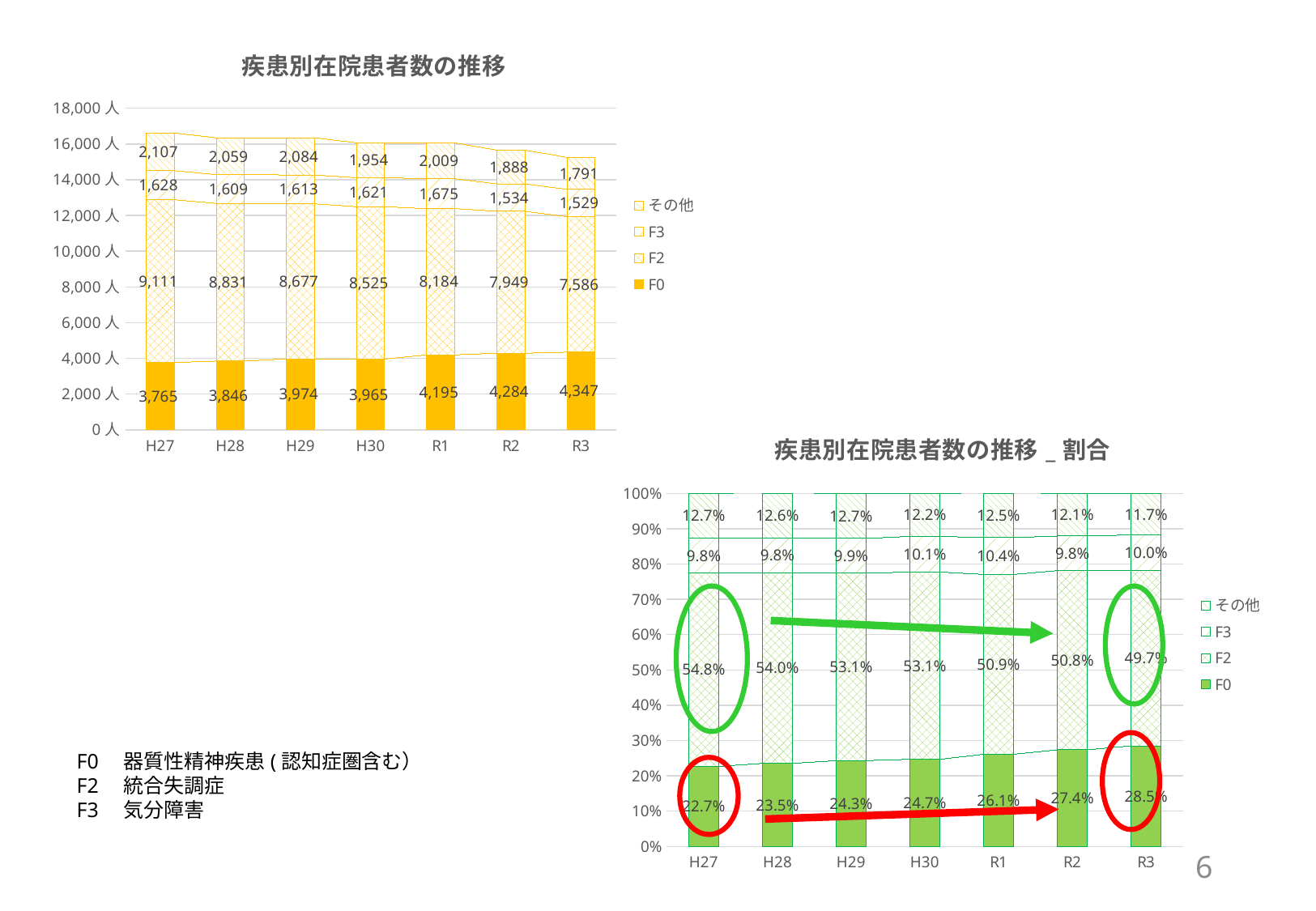
In the chart titled 疾患別在院患者数の推移＿割合, what is the value for F2 in H27? 54.8% What kind of chart is the chart titled 疾患別在院患者数の推移＿割合? stacked bar chart In the chart titled 疾患別在院患者数の推移, does the F2 value rise or fall from H27 to R3? fall In the chart titled 疾患別在院患者数の推移, which year has the highest F0 value? R3 In the chart titled 疾患別在院患者数の推移＿割合, what is the value for F0 in R3? 28.5% In the chart titled 疾患別在院患者数の推移, what is the value for F2 in R3? 7,586 In the chart titled 疾患別在院患者数の推移, what is the total of the stacked bar for R3? 15,253 In the chart titled 疾患別在院患者数の推移, what is the difference between the F2 values for H27 and R3? 1,525 In the chart titled 疾患別在院患者数の推移＿割合, which year has the lowest F2 share? R3 In the chart titled 疾患別在院患者数の推移, what is the value for F0 in H27? 3,765 In the chart titled 疾患別在院患者数の推移, how many series does the legend list? 4 In the chart titled 疾患別在院患者数の推移, what is the value for その他 in H30? 1,954